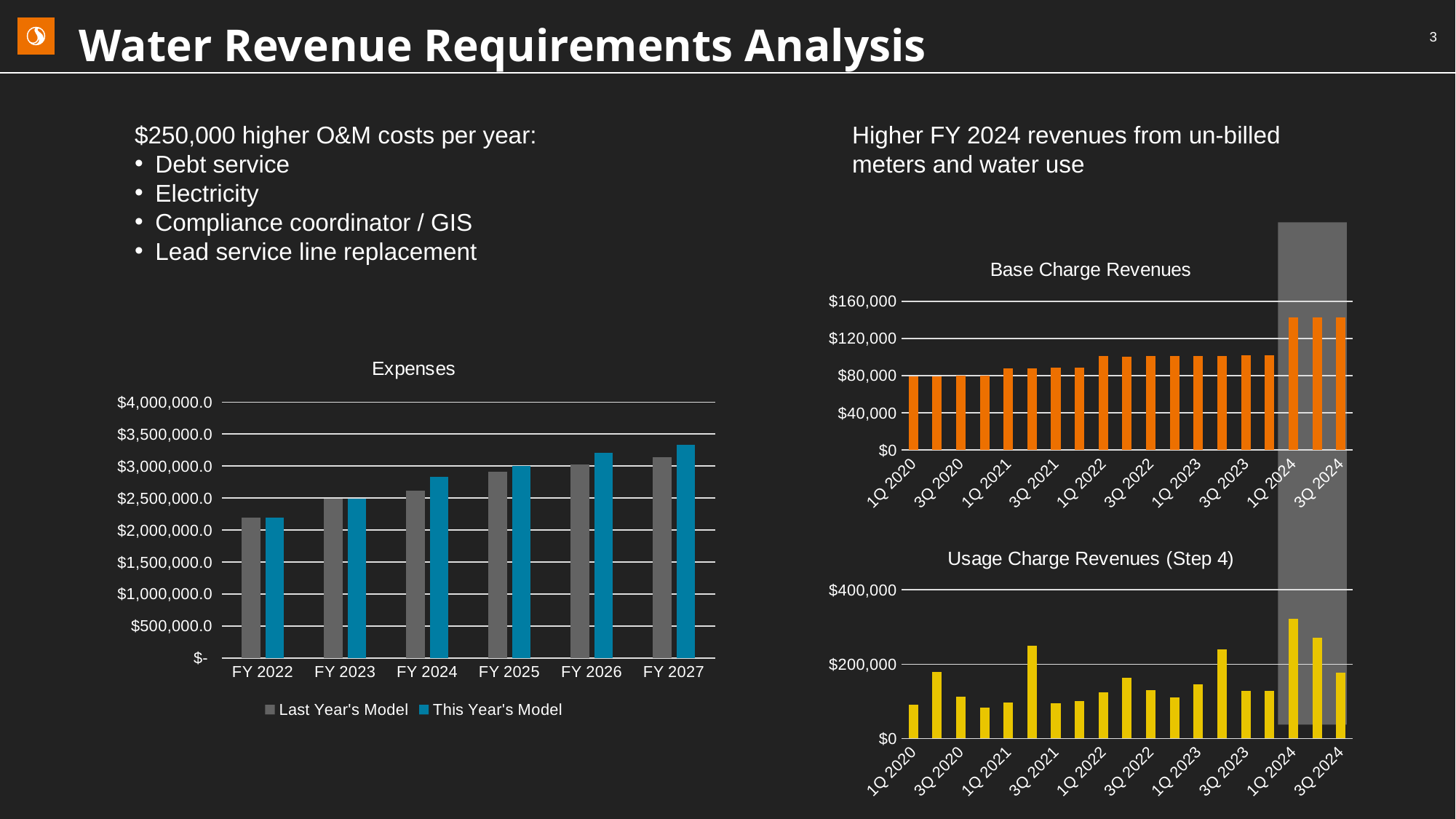
In the Base Charge Revenues chart, is the value for 3Q 2024 greater or less than $120,000? greater In the Expenses chart, do the This Year's Model values rise or fall from FY 2022 to FY 2027? rise In the Usage Charge Revenues (Step 4) chart, which quarter has the highest value? 1Q 2024 In the Base Charge Revenues chart, is the value for 1Q 2020 greater or less than $120,000? less In the Expenses chart, is the This Year's Model value for FY 2027 greater or less than $3,000,000.0? greater How many fiscal years are shown on the x axis of the Expenses chart? 6 In the Expenses chart, which series is shown in blue? This Year's Model In the Expenses chart, which is larger for FY 2026: Last Year's Model or This Year's Model? This Year's Model What type of chart is the Expenses chart? bar chart How many series does the legend of the Expenses chart list? 2